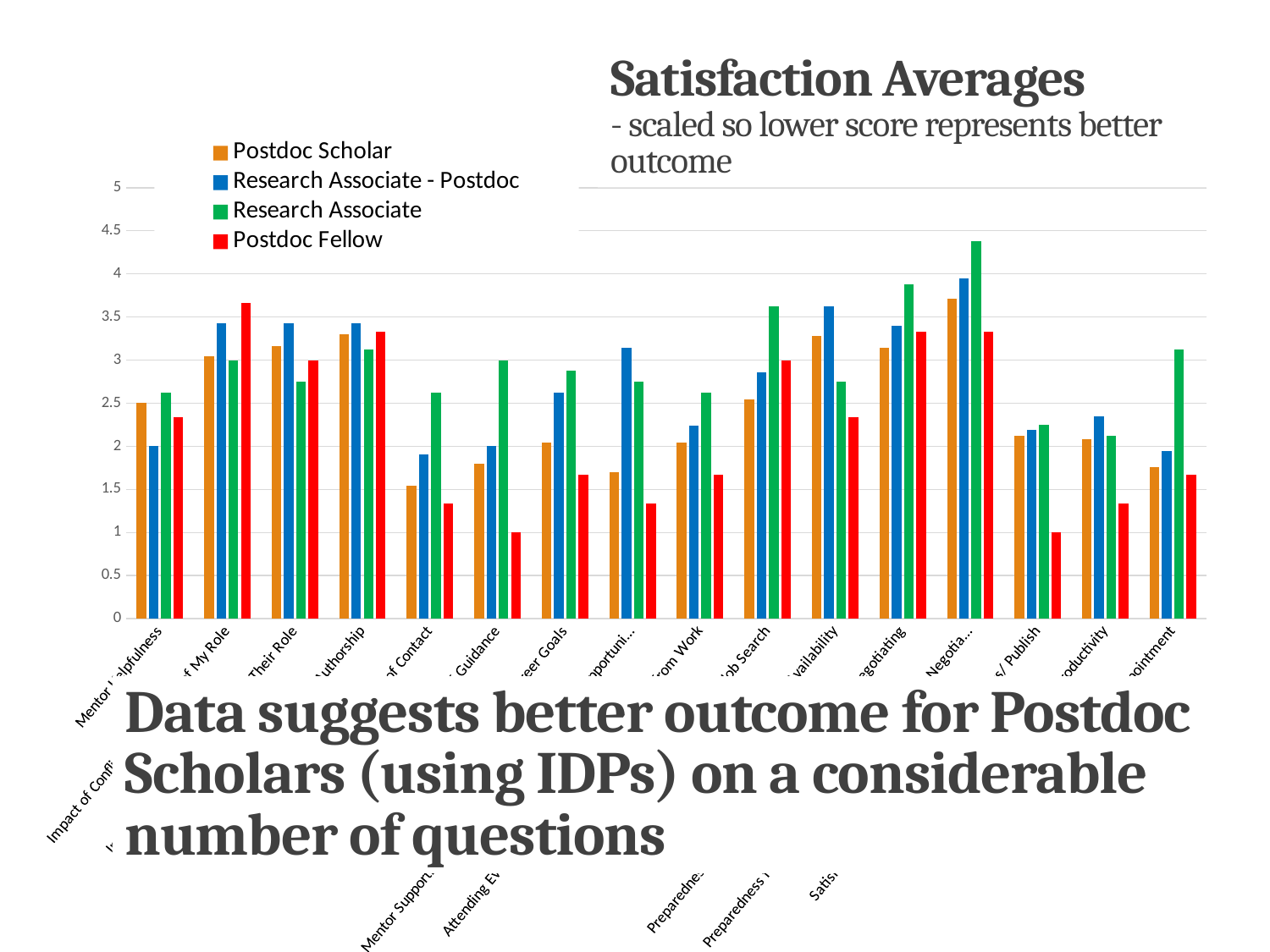
For Job Search, which series has the highest value? Research Associate For Authorship, which is larger: the Research Associate - Postdoc value or the Research Associate value? Research Associate - Postdoc For Availability, which series has the highest value? Research Associate - Postdoc How many series does the legend list? 4 How many category groups are plotted along the x axis? 16 Is the Postdoc Fellow value for Authorship greater or less than 3? greater For Productivity, which series has the lowest value? Postdoc Fellow What kind of chart is shown on the slide? bar chart Which colour represents the Postdoc Fellow series? red What is the title of the chart? Satisfaction Averages Is the Postdoc Fellow value for Productivity greater or less than 1.5? less Is the Research Associate value for Job Search greater or less than 3? greater